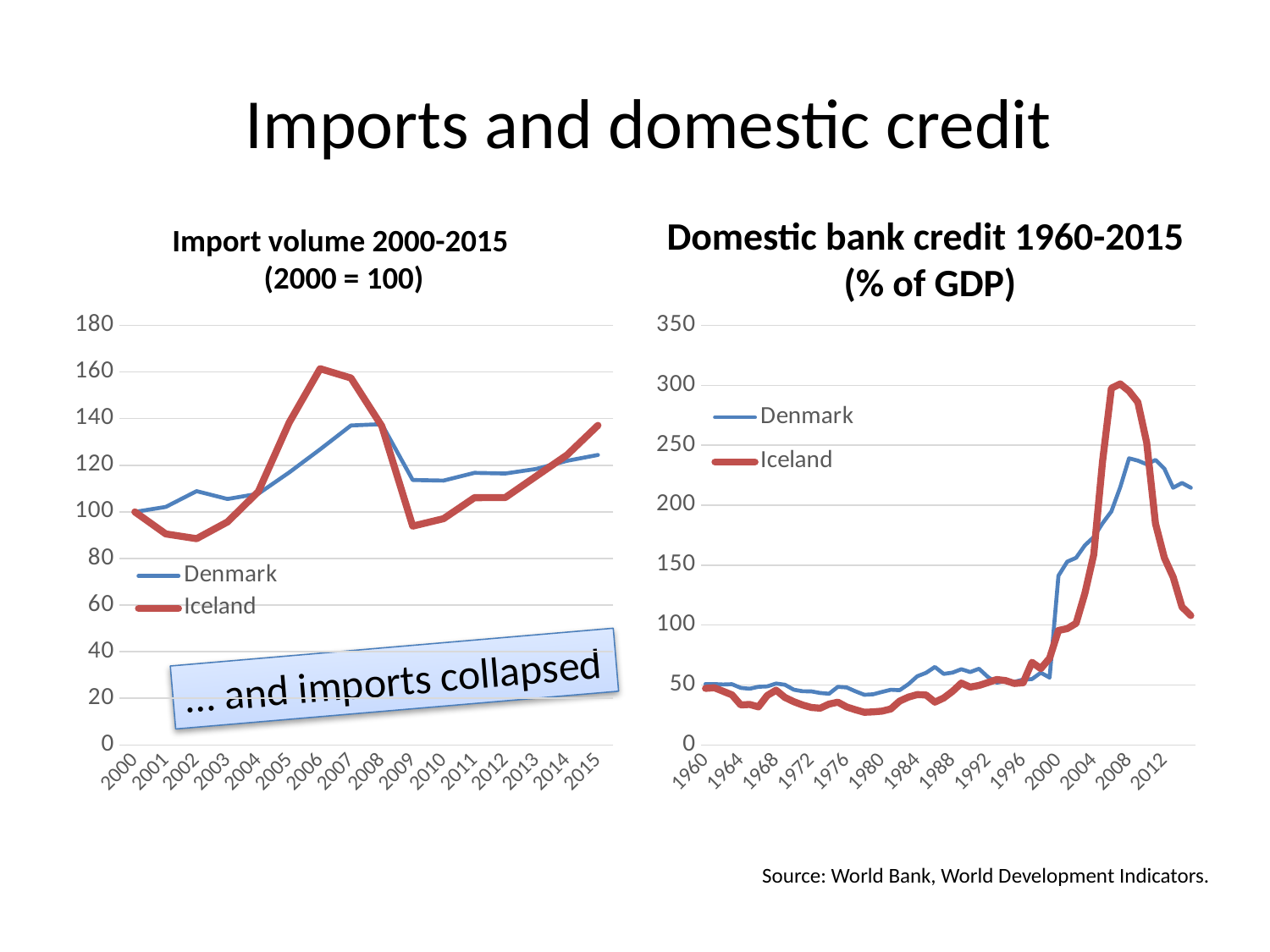
In the 'Import volume 2000-2015' chart, is the value for Iceland in 2009 greater or less than 100? less In the 'Domestic bank credit 1960-2015' chart, which series reaches the highest peak value? Iceland In the 'Import volume 2000-2015' chart, is the value for Iceland in 2006 greater or less than 140? greater In the 'Import volume 2000-2015' chart, which series reaches the highest peak value? Iceland What kind of chart is the 'Import volume 2000-2015' chart on the left? line chart How many years are plotted along the x axis of the 'Import volume 2000-2015' chart? 16 In the 'Domestic bank credit 1960-2015' chart, which series has the higher value at the end of the period (2015), Denmark or Iceland? Denmark In the 'Domestic bank credit 1960-2015' chart, does the Iceland line rise or fall between 2008 and 2015? fall In the 'Domestic bank credit 1960-2015' chart, is the value for Iceland in 2008 greater or less than 250? greater How many series does the legend of the 'Import volume 2000-2015' chart list? 2 In the 'Import volume 2000-2015' chart, which series has the higher value in 2015, Denmark or Iceland? Iceland In the 'Import volume 2000-2015' chart, what is the value for Denmark in 2000? 100